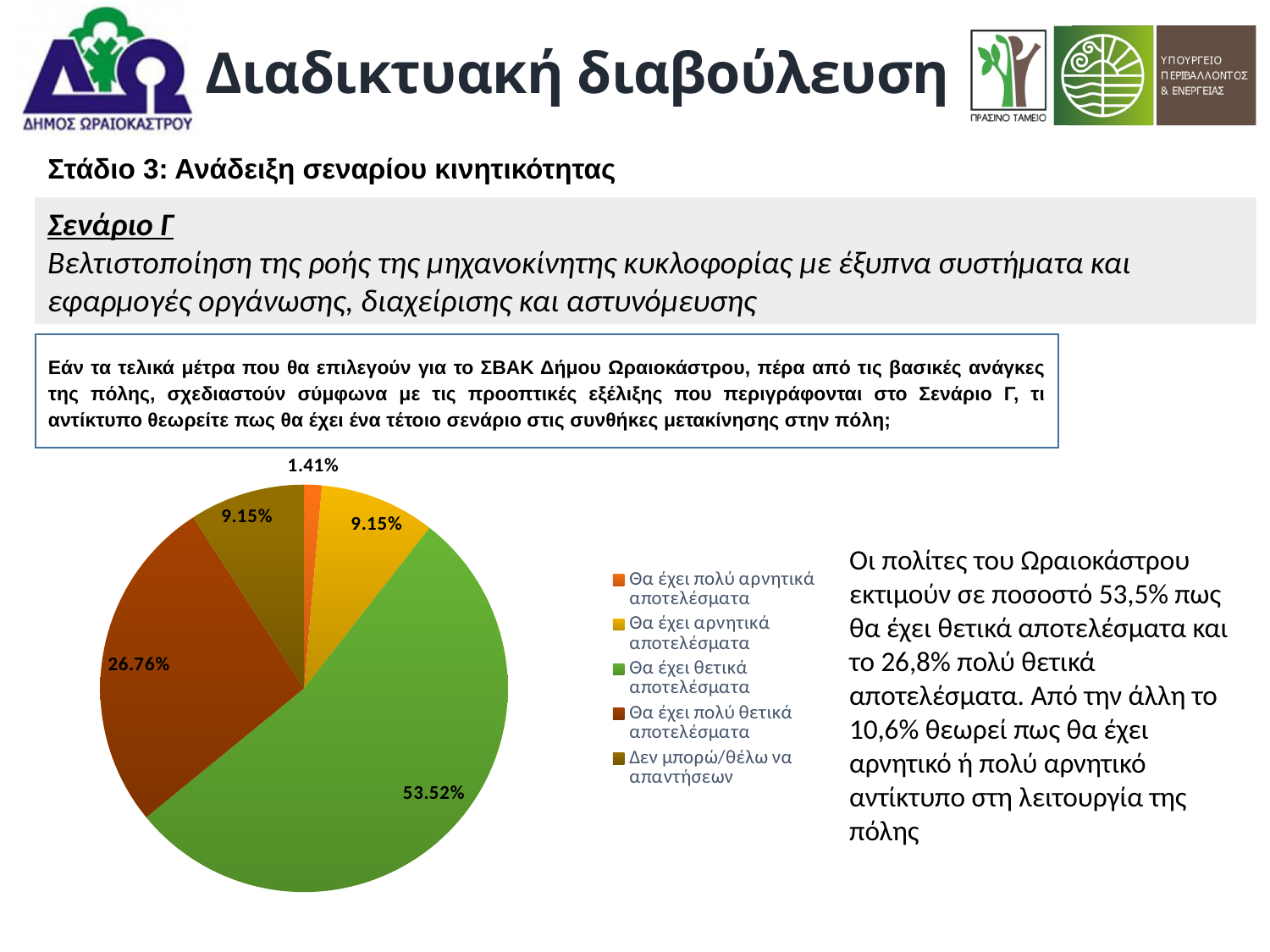
What percentage of respondents answered "Θα έχει πολύ αρνητικά αποτελέσματα"? 1.41% How many entries does the legend of the pie chart list? 5 What is the difference in percentage points between "Θα έχει θετικά αποτελέσματα" and "Θα έχει πολύ θετικά αποτελέσματα"? 26.76 Which is larger: the share for "Θα έχει πολύ θετικά αποτελέσματα" or the share for "Δεν μπορώ/θέλω να απαντήσεων"? Θα έχει πολύ θετικά αποτελέσματα What percentage of respondents answered "Θα έχει θετικά αποτελέσματα"? 53.52% How many slices does the pie chart have? 5 What type of chart is shown on the slide? pie chart What percentage of respondents answered "Θα έχει αρνητικά αποτελέσματα"? 9.15% What percentage of respondents answered "Θα έχει πολύ θετικά αποτελέσματα"? 26.76% Which response has the smallest share of the pie chart? Θα έχει πολύ αρνητικά αποτελέσματα Which response has the largest share of the pie chart? Θα έχει θετικά αποτελέσματα What colour is the slice for "Θα έχει θετικά αποτελέσματα" in the pie chart? green